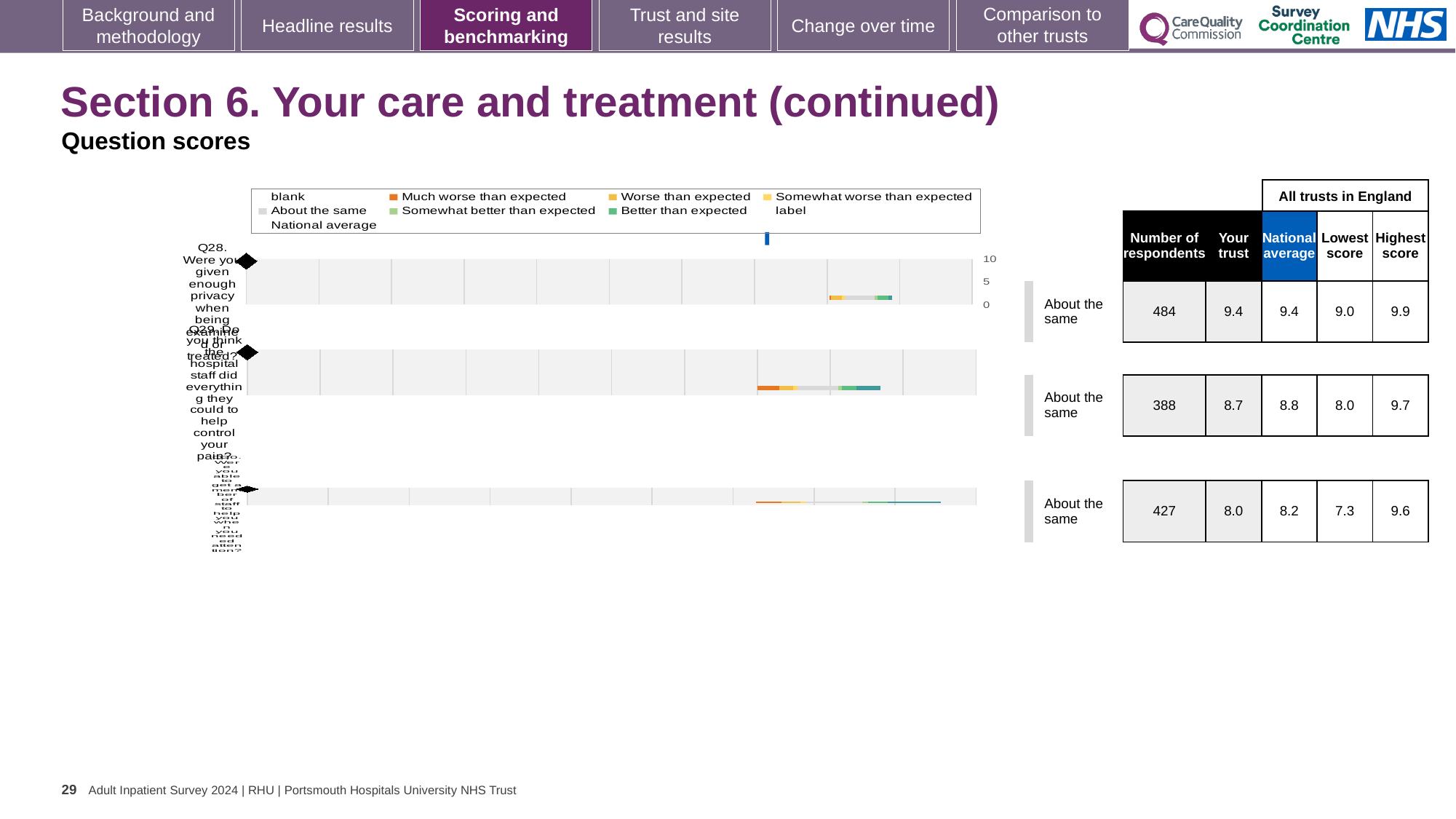
What kind of chart is used to show the question scores on this slide? bar chart Which question has the lowest 'Lowest score' value? Q30 What colour does the legend use for 'Much worse than expected'? Orange What is the highest score across all trusts in England shown for Q28? 9.9 What is the national average shown for Q29? 8.8 How many questions are plotted in the chart? 3 How many respondents are shown for Q30? 427 Which question has the highest 'Your trust' score? Q28 For Q29, which is larger: the 'Your trust' score or the national average? National average What benchmark category is shown next to the Q28 bar? About the same What is the 'Your trust' score shown for Q28? 9.4 What is the difference between the highest score and the lowest score for Q30? 2.3